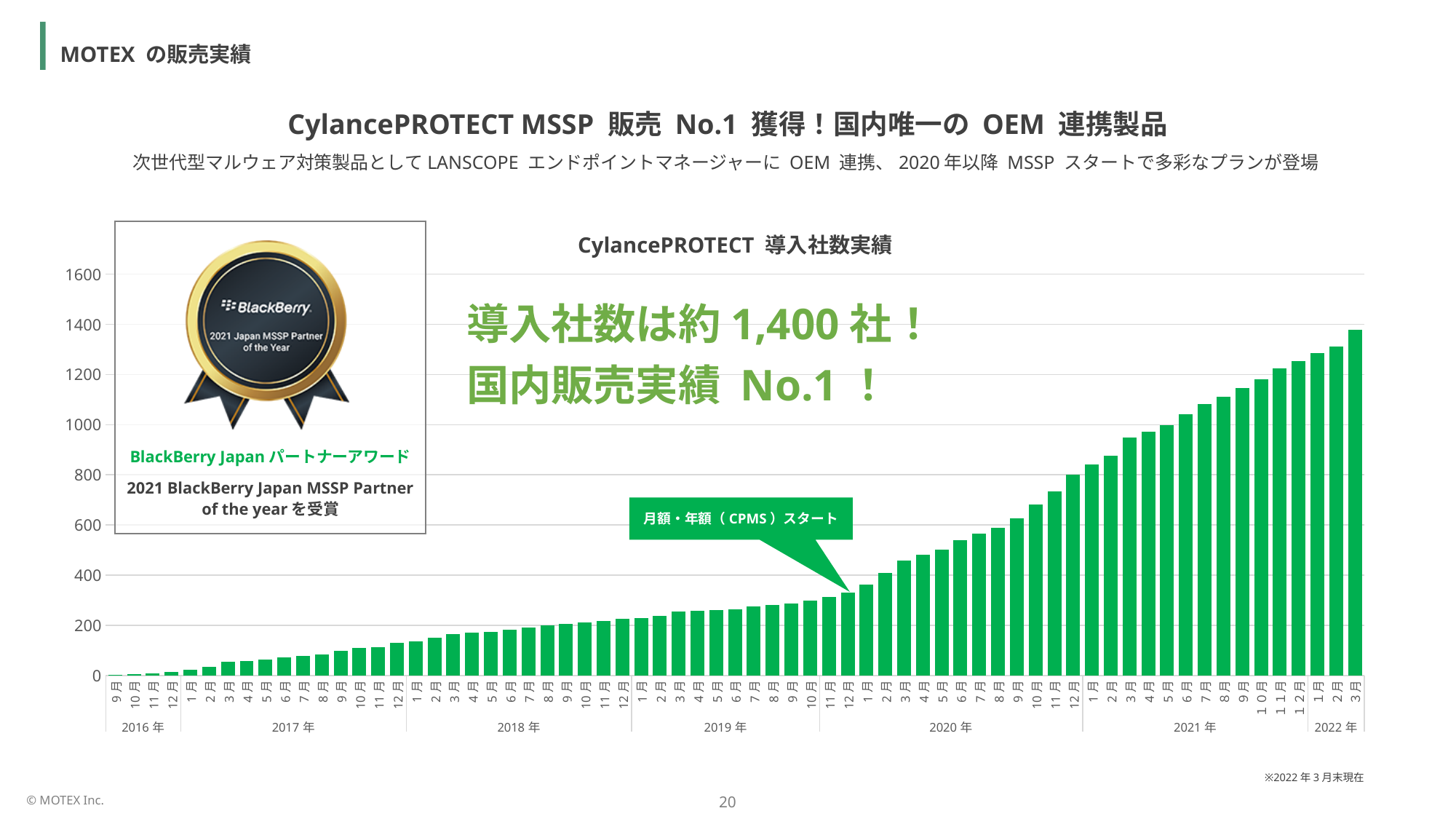
Which month has the lowest value in the chart? 2016年9月 Is the value for 2020年6月 greater or less than 400? greater Do the values in the chart rise or fall from left to right along the x axis? rise Which is larger, the value for 2021年3月 or the value for 2019年3月? 2021年3月 Which month has the highest value in the chart? 2022年3月 Is the value for 2019年12月 greater or less than 400? less Is the value for 2018年12月 greater or less than 200? greater How many monthly bars are plotted in the chart? 67 What kind of chart is shown on the slide? bar chart What is the title of the chart? CylancePROTECT 導入社数実績 What does the callout label pointing at the bars around the end of 2019 say? 月額・年額（CPMS）スタート